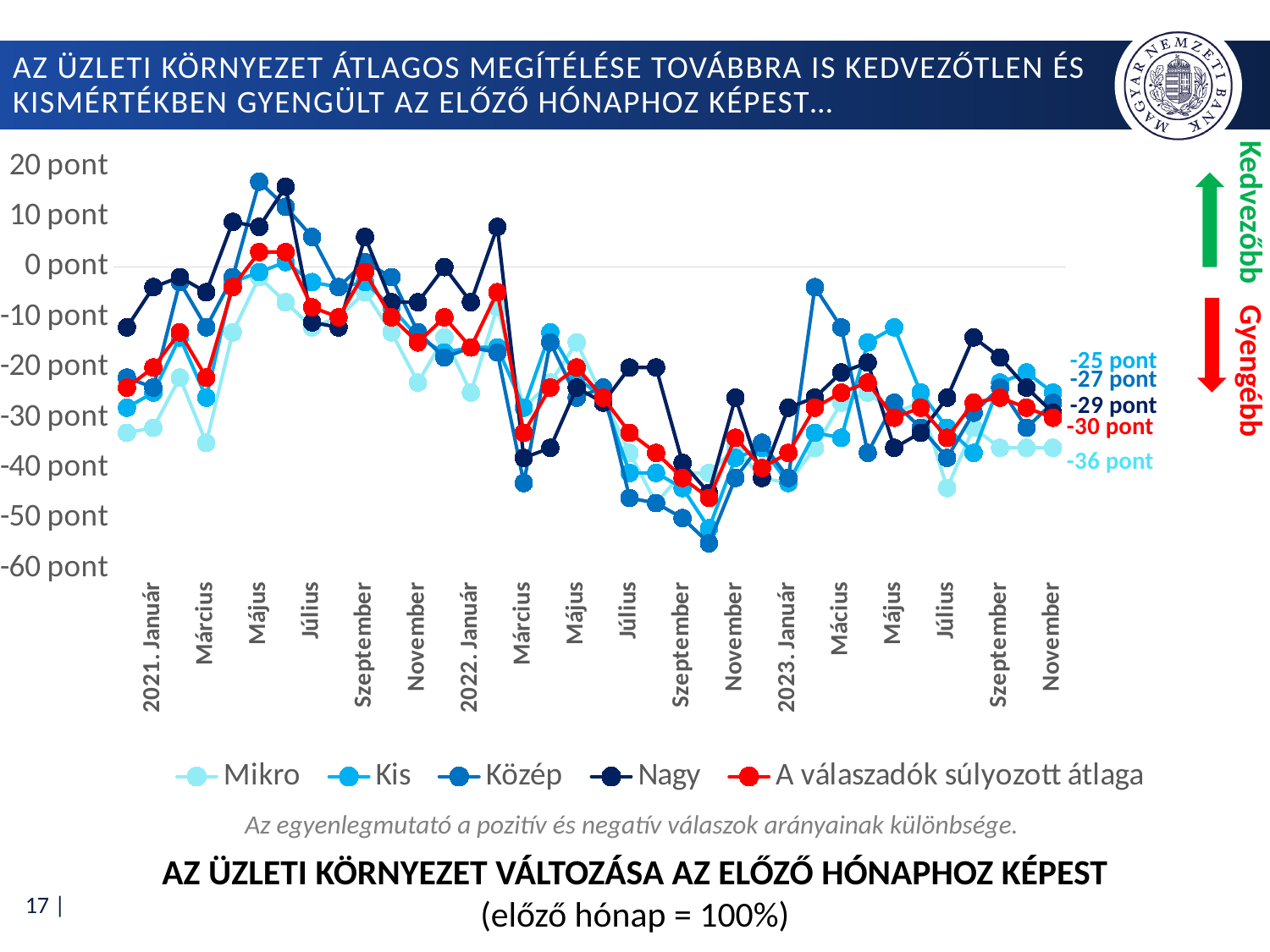
At the end of the chart, which is larger: the value for Nagy or the value for 'A válaszadók súlyozott átlaga'? Nagy What is the value labelled for the Mikro series at the end of the chart (November 2023)? -36 pont What kind of chart is shown on the slide? line chart What is the name of the last series listed in the legend? A válaszadók súlyozott átlaga Is the value for Közép in May 2021 greater or less than 10 pont? greater What is the value labelled for the Nagy series at the end of the chart? -29 pont Does the 'A válaszadók súlyozott átlaga' series end higher or lower in November 2023 than it started in January 2021? lower How many series does the legend list? 5 What is the difference between the end-of-chart values of Kis (-25 pont) and Mikro (-36 pont)? 11 pont Which series has the lowest value at the end of the chart (November 2023)? Mikro Which series has the highest value at the end of the chart (November 2023)? Kis What is the value labelled for 'A válaszadók súlyozott átlaga' at the end of the chart? -30 pont